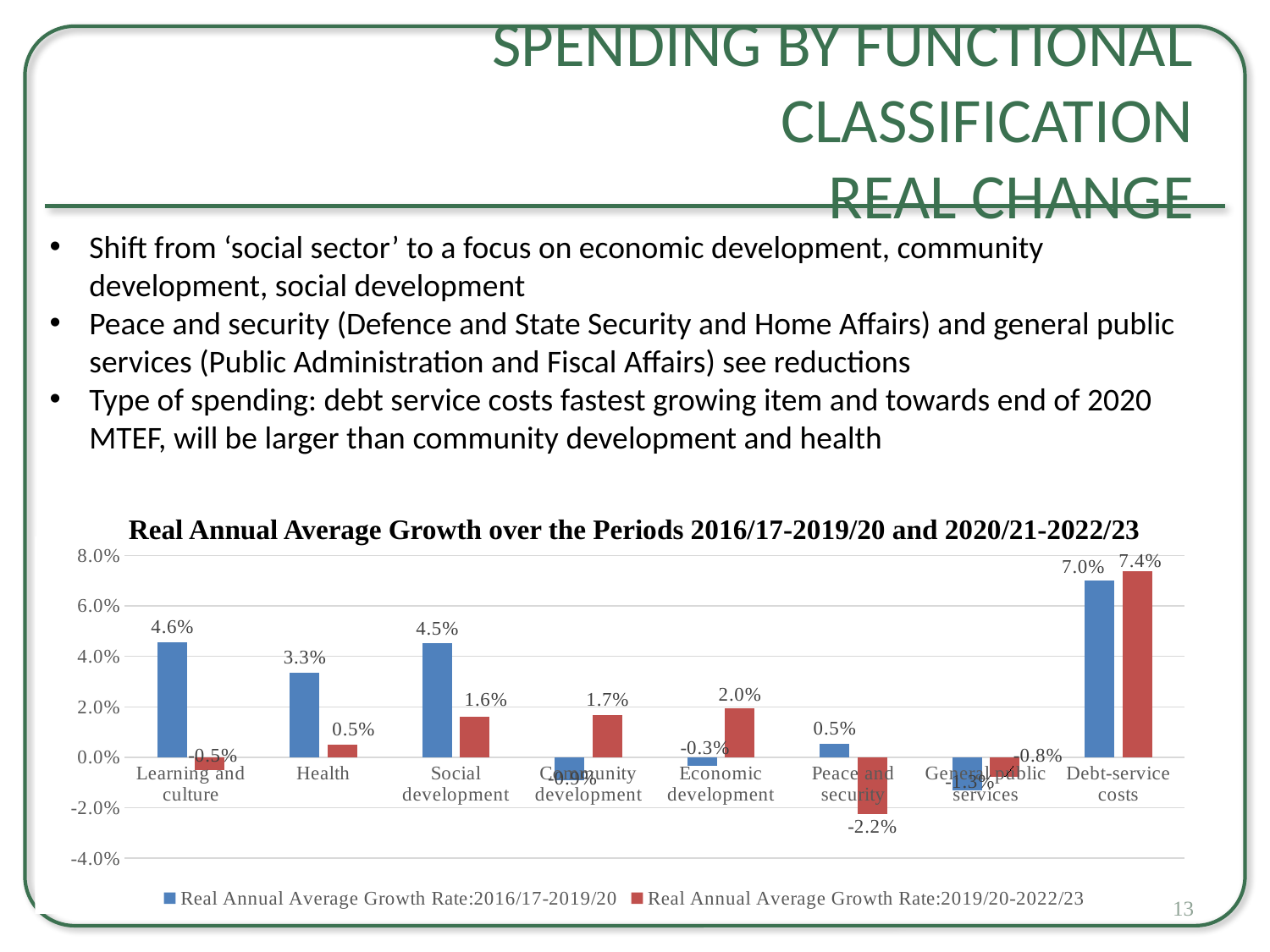
For the 2016/17-2019/20 period, which is larger: Health or Social development? Social development How many categories are shown on the x axis of the chart? 8 Which category has the lowest Real Annual Average Growth Rate for 2019/20-2022/23? Peace and security What is the Real Annual Average Growth Rate for 2016/17-2019/20 for Debt-service costs? 7.0% What is the difference between the 2019/20-2022/23 and 2016/17-2019/20 growth rates for Debt-service costs? 0.4 percentage points Which category has the highest Real Annual Average Growth Rate for 2016/17-2019/20? Debt-service costs Which category has the highest Real Annual Average Growth Rate for 2019/20-2022/23? Debt-service costs What is the Real Annual Average Growth Rate for 2019/20-2022/23 for Peace and security? -2.2% What kind of chart is shown on the slide? Bar chart How many series does the legend list? 2 What is the difference between the 2016/17-2019/20 and 2019/20-2022/23 growth rates for Learning and culture? 5.1 percentage points What is the Real Annual Average Growth Rate for 2016/17-2019/20 for Learning and culture? 4.6%